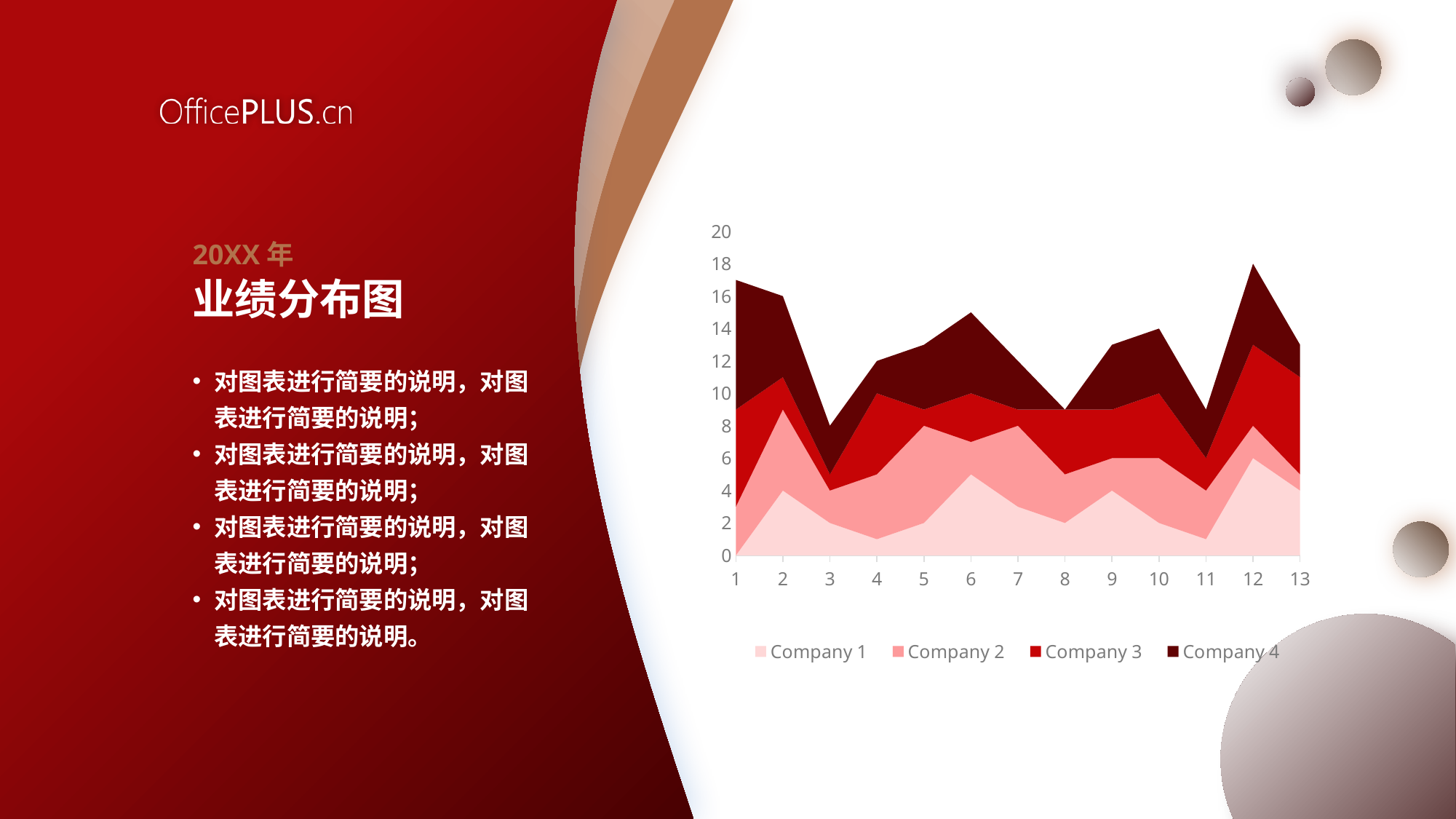
Which is larger: the stacked total at x-axis point 12 or at x-axis point 11? Point 12 What are the series names listed in the chart legend? Company 1, Company 2, Company 3, Company 4 Is the value for Company 1 at x-axis point 4 greater or less than 2? less How many series does the chart legend list? 4 At which x-axis point does the stacked total reach its highest value? 12 Is the stacked total at x-axis point 3 greater or less than 10? less Is the value for Company 1 at x-axis point 6 greater or less than 4? greater What is the title of the chart shown on the slide? 业绩分布图 How many points are plotted along the x axis of the chart? 13 What kind of chart is shown on the slide? Stacked area chart